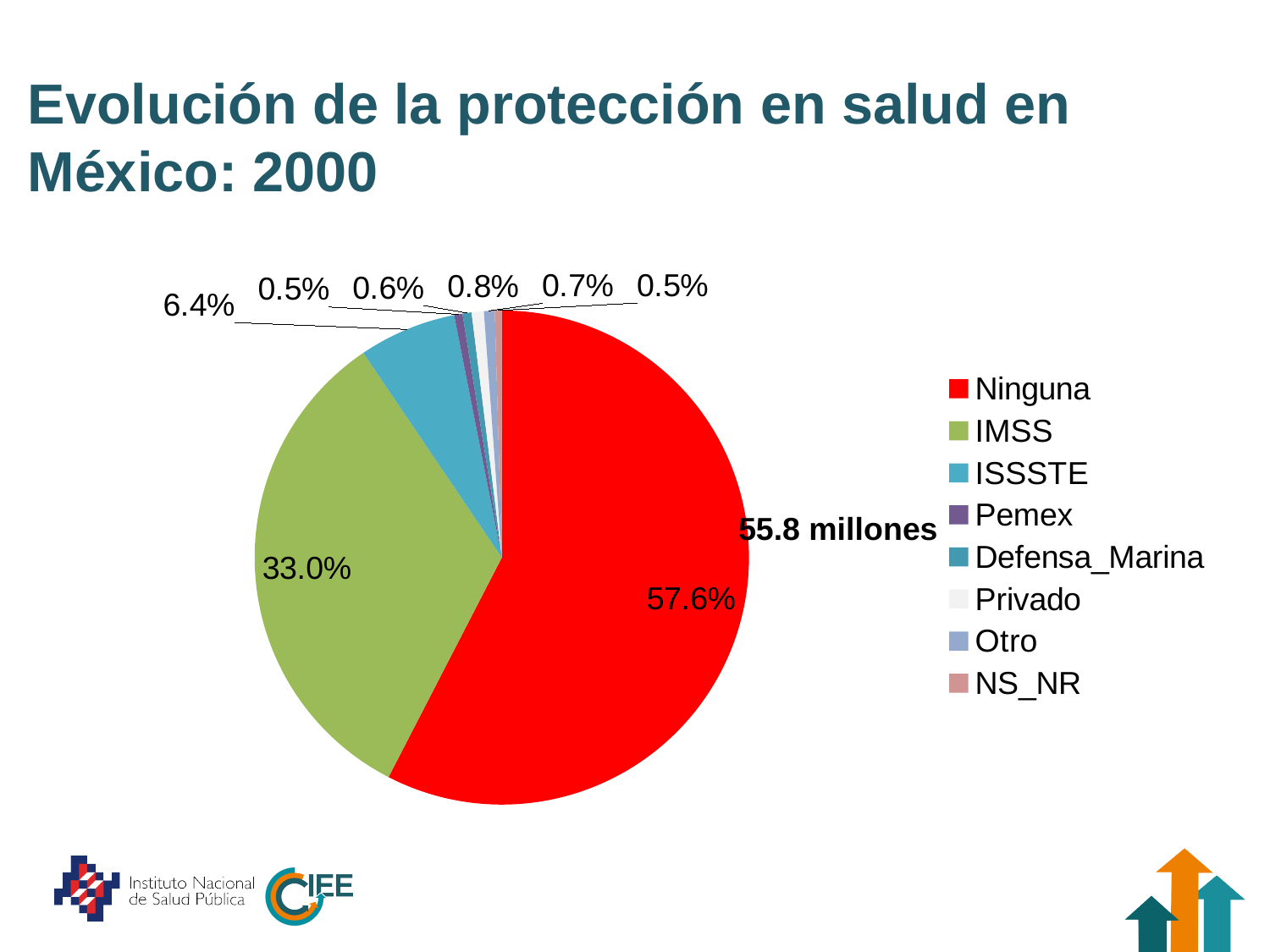
What type of chart is shown on the slide? pie chart What is the difference in percentage points between the Ninguna slice and the IMSS slice? 24.6 percentage points What total population figure is printed next to the pie chart? 55.8 millones What share of the pie does IMSS represent? 33.0% What share of the pie does Ninguna represent? 57.6% How many categories does the legend list? 8 Which category has the largest slice of the pie? Ninguna Which is larger, the slice for IMSS or the slice for ISSSTE? IMSS What colour is the slice for Ninguna? red What share of the pie does ISSSTE represent? 6.4% What is the difference in percentage points between the IMSS slice and the ISSSTE slice? 26.6 percentage points Which category is listed last in the legend? NS_NR